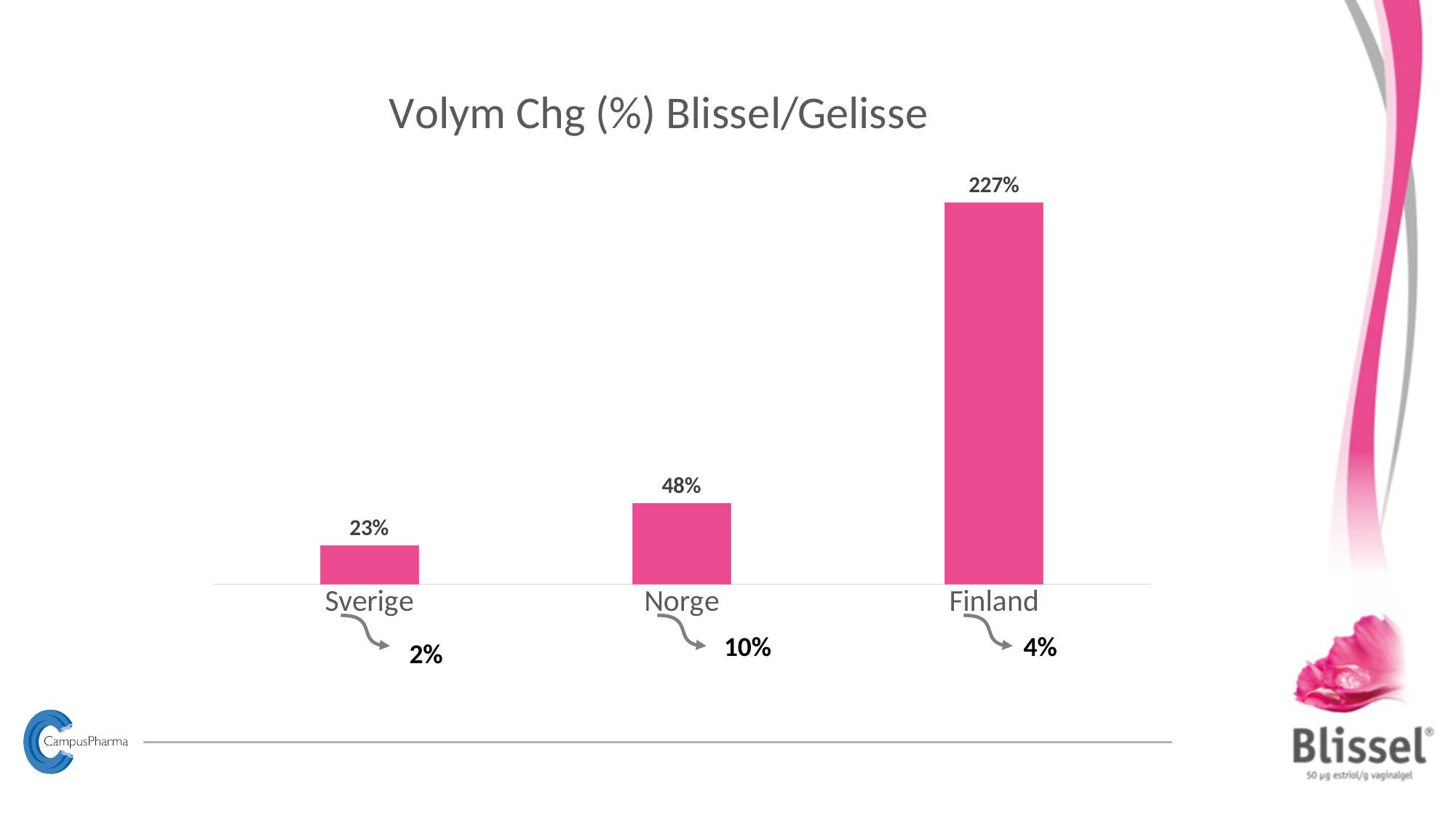
What is the difference between the values for Norge and Sverige? 25% Do the values rise or fall from left to right across the categories? Rise What is the value for Sverige? 23% What is the difference between the values for Finland and Norge? 179% What is the value for Finland? 227% Which category has the highest value? Finland What is the title of the chart? Volym Chg (%) Blissel/Gelisse Which category has the lowest value? Sverige What is the value for Norge? 48% What kind of chart is this? Bar chart Which is larger, the value for Norge or the value for Sverige? Norge How many categories are shown in the chart? 3